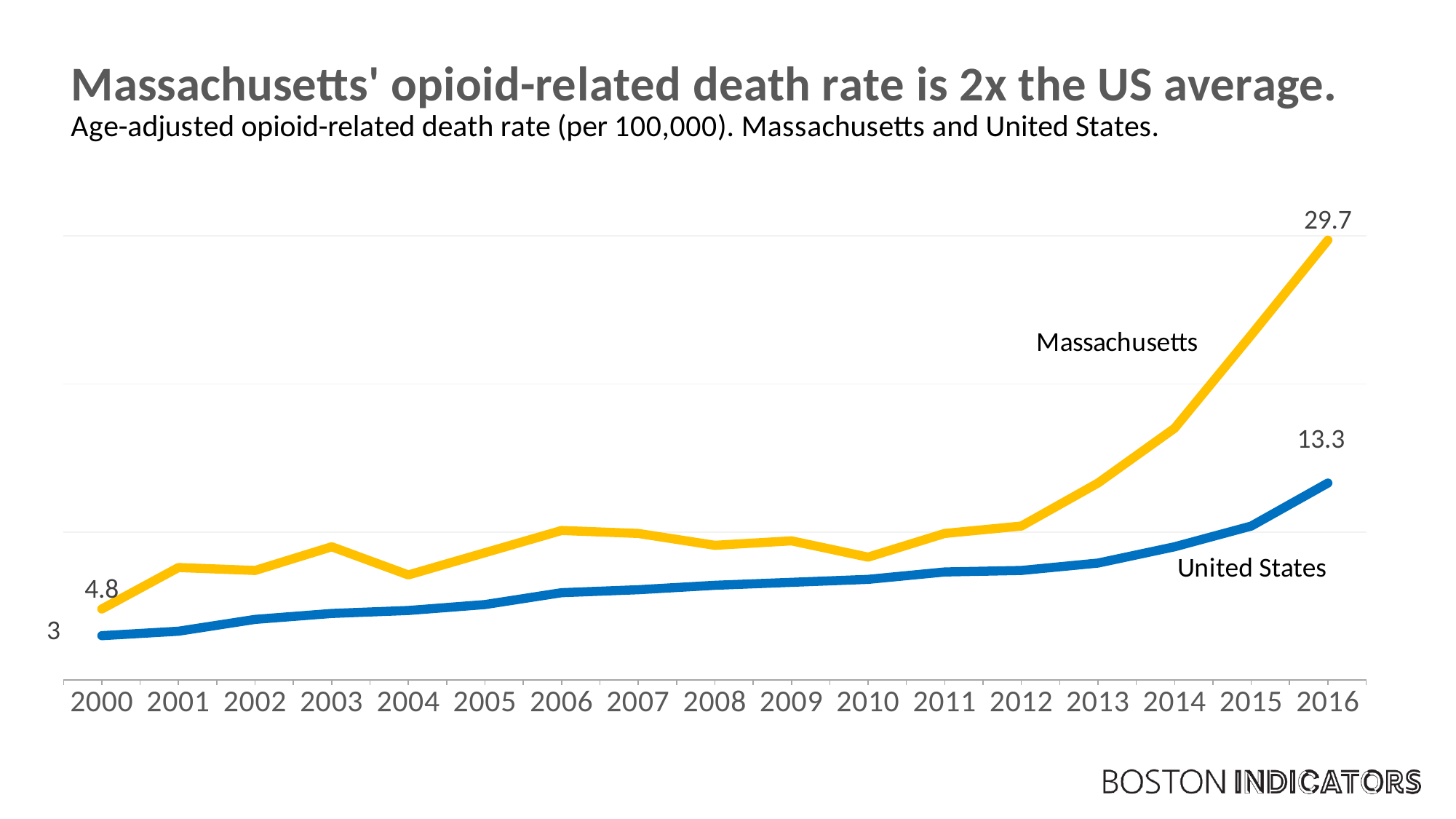
What is the difference between the Massachusetts and United States death rates in 2016? 16.4 Which has the higher opioid-related death rate in 2016, Massachusetts or the United States? Massachusetts What kind of chart is shown on the slide? Line chart By how much did the United States death rate increase from 2000 to 2016? 10.3 By how much did the Massachusetts death rate increase from 2000 to 2016? 24.9 What is the Massachusetts opioid-related death rate in 2016? 29.7 In which year does the Massachusetts line reach its highest value? 2016 What is the United States opioid-related death rate in 2016? 13.3 How many years are shown on the x axis? 17 What is the Massachusetts opioid-related death rate in 2000? 4.8 How many series are plotted on the chart? 2 What is the United States opioid-related death rate in 2000? 3